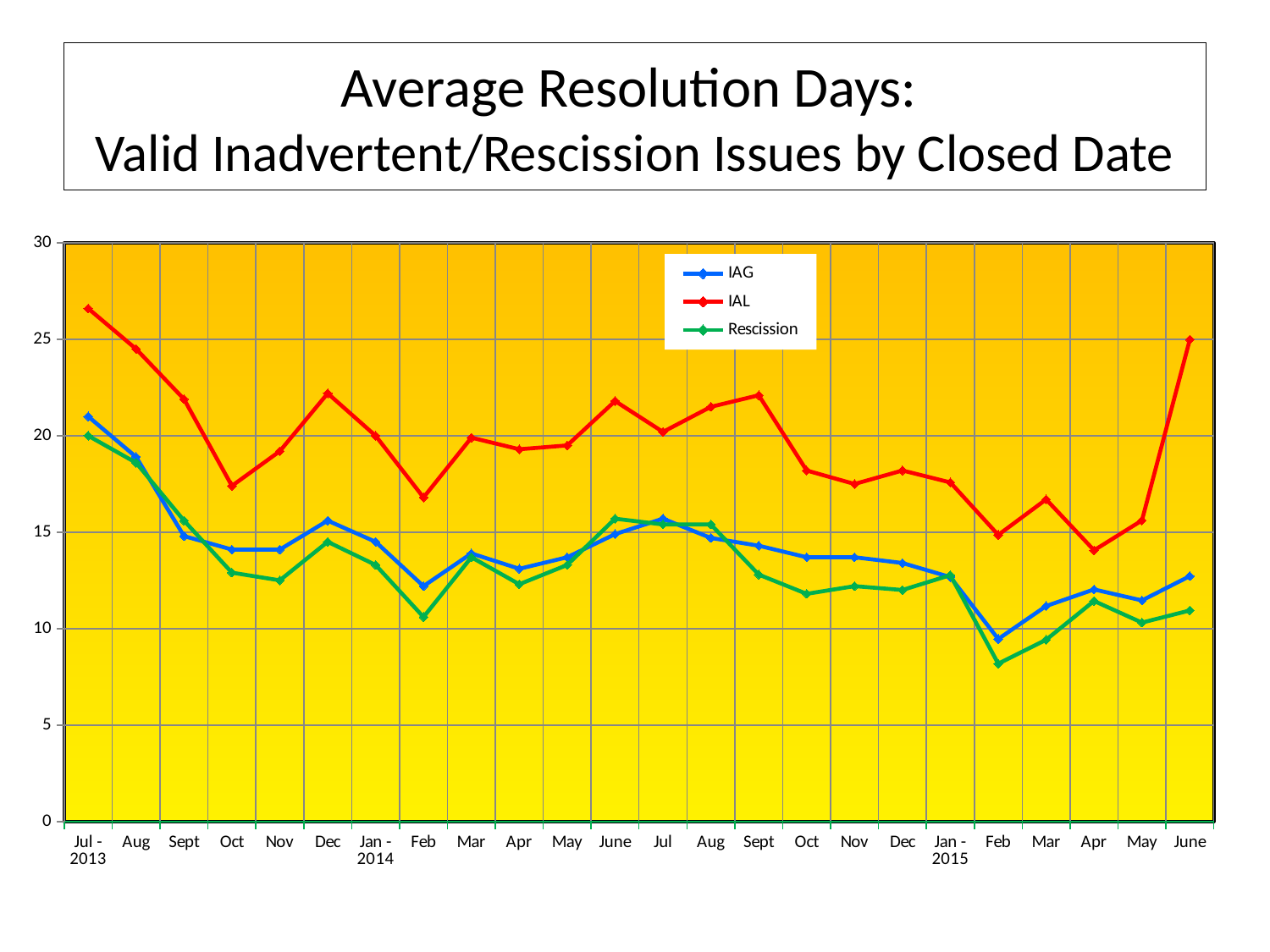
How many months are plotted along the x axis? 24 Does the IAL series rise or fall from Apr 2015 to June 2015? rise Which series is drawn in red? IAL What kind of chart is shown on the slide? line chart Is the IAG value for Jul-2013 greater or less than 20? greater Which series has the highest values across the whole chart? IAL Is the IAL value for Jul-2013 greater or less than 25? greater How many series does the legend list? 3 In which month does the IAG series reach its highest value? Jul-2013 Is the Rescission value for Feb 2015 greater or less than 10? less In which month does the Rescission series reach its lowest value? Feb 2015